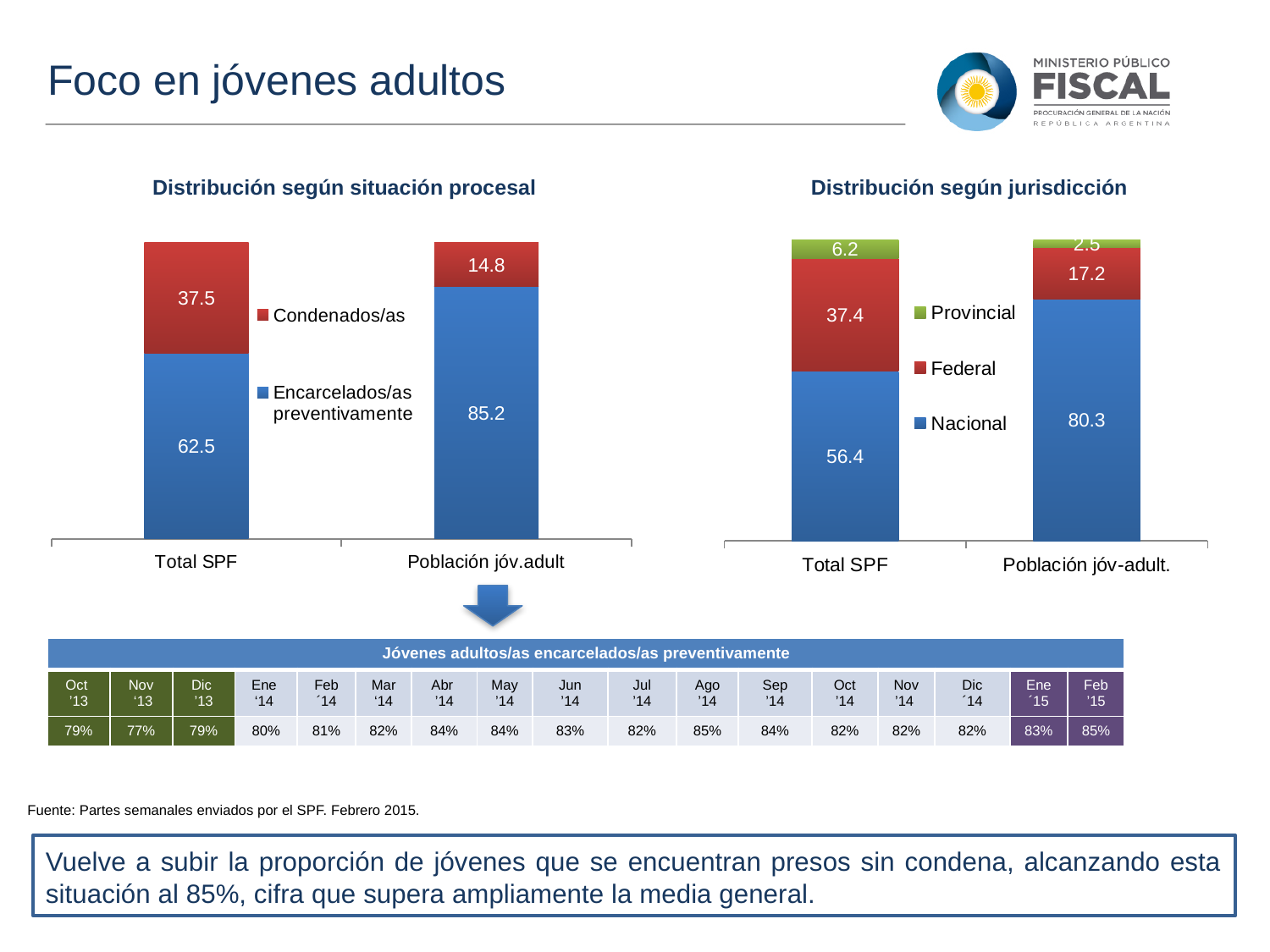
In the chart 'Distribución según situación procesal', which category has the higher Condenados/as value? Total SPF In the chart 'Distribución según situación procesal', how many series does the legend list? 2 What type of chart is 'Distribución según situación procesal'? Stacked bar chart In the chart 'Distribución según jurisdicción', what is the Provincial value for Total SPF? 6.2 In the chart 'Distribución según situación procesal', what is the value for Encarcelados/as preventivamente in the Total SPF bar? 62.5 In the chart 'Distribución según jurisdicción', what is the Nacional value for Población jóv-adult.? 80.3 In the chart 'Distribución según jurisdicción', which series has the smallest value in the Población jóv-adult. bar? Provincial In the chart 'Distribución según jurisdicción', what is the Federal value for Población jóv-adult.? 17.2 In the chart 'Distribución según jurisdicción', how many series does the legend list? 3 In the chart 'Distribución según situación procesal', what is the value for Condenados/as in the Población jóv.adult bar? 14.8 In the chart 'Distribución según situación procesal', what is the difference between the Encarcelados/as preventivamente values for Población jóv.adult and Total SPF? 22.7 In the chart 'Distribución según jurisdicción', what is the total of the Total SPF stacked bar? 100